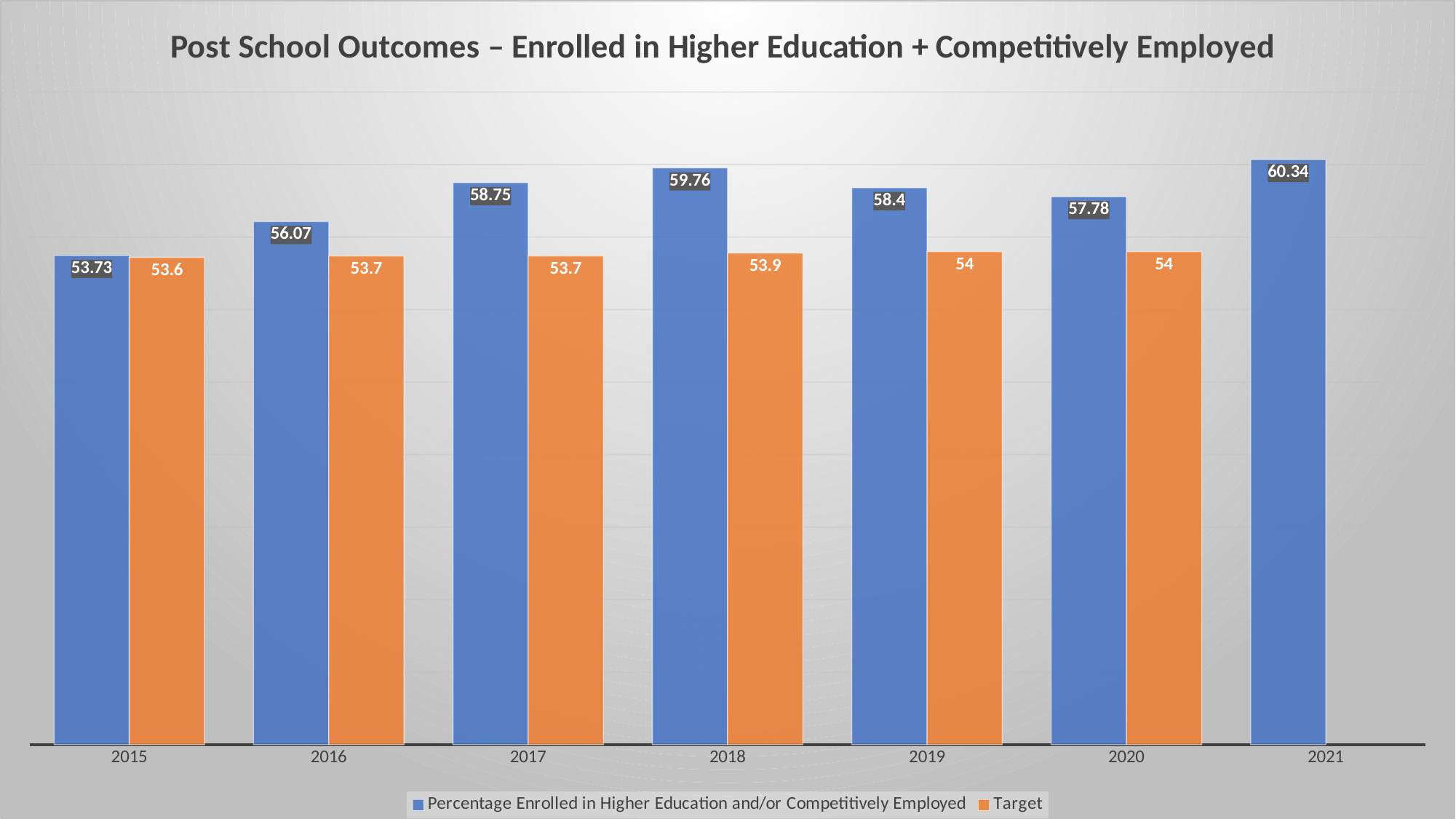
What is the Percentage Enrolled in Higher Education and/or Competitively Employed for 2018? 59.76 Which year has the lowest Percentage Enrolled in Higher Education and/or Competitively Employed? 2015 How many years are shown on the x axis? 7 Which is larger in 2020: the Percentage Enrolled in Higher Education and/or Competitively Employed or the Target? Percentage Enrolled in Higher Education and/or Competitively Employed What is the difference between the Percentage Enrolled in Higher Education and/or Competitively Employed and the Target in 2017? 5.05 Which year has the highest Percentage Enrolled in Higher Education and/or Competitively Employed? 2021 What is the Target value for 2019? 54 What colour are the Target bars? Orange What kind of chart is shown on the slide? Bar chart What is the Percentage Enrolled in Higher Education and/or Competitively Employed for 2015? 53.73 Does the Target value rise or fall from 2015 to 2020? Rise How many series does the legend list? 2